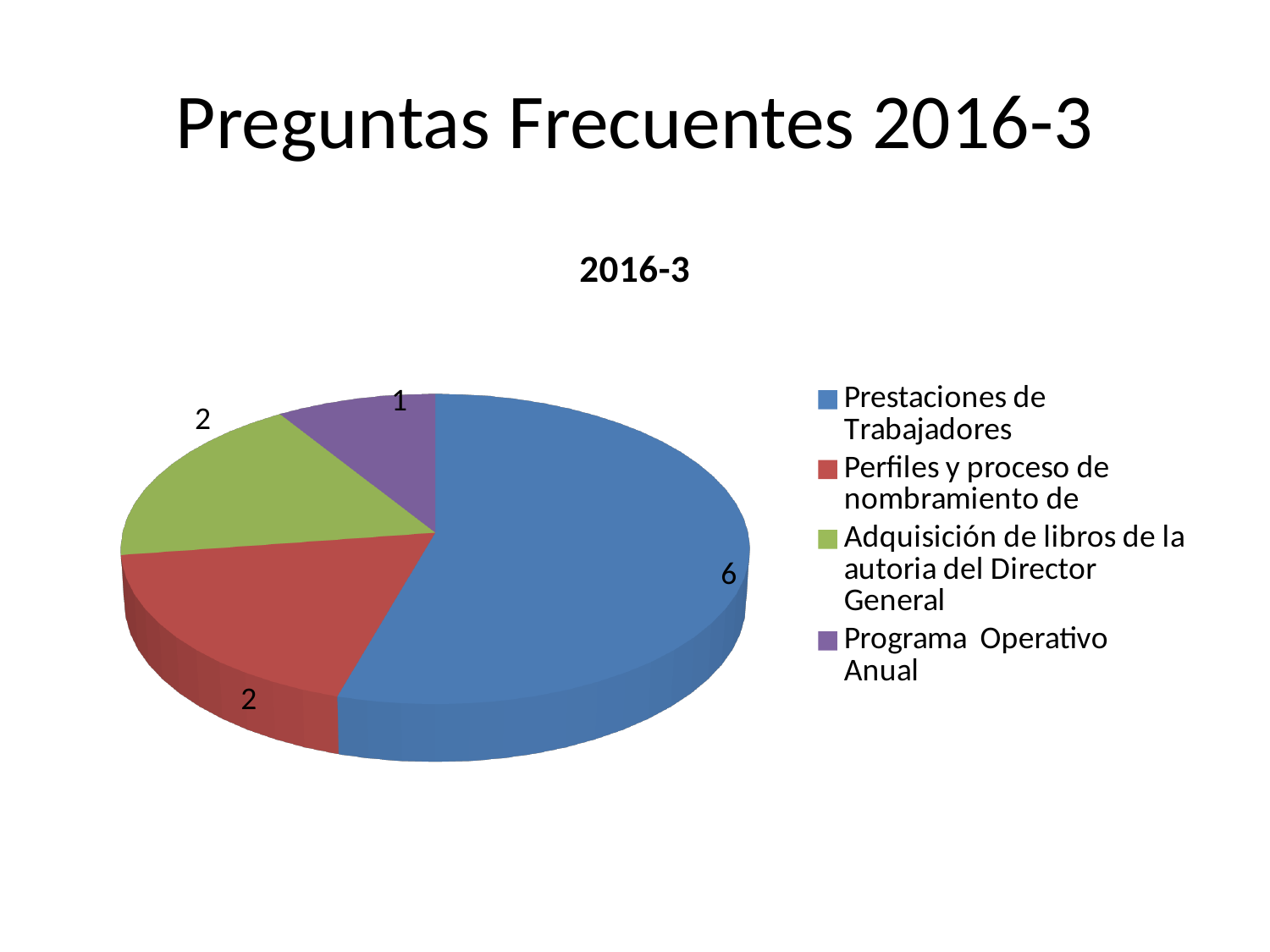
How many categories does the pie chart show? 4 What is the value for Adquisición de libros de la autoria del Director General? 2 What is the title of the chart? 2016-3 What type of chart is shown on the slide? pie chart Which category has the largest slice of the pie? Prestaciones de Trabajadores What is the difference between the values for Prestaciones de Trabajadores and Perfiles y proceso de nombramiento de? 4 What is the value for Programa Operativo Anual? 1 What is the value for Prestaciones de Trabajadores? 6 Which is larger, the value for Prestaciones de Trabajadores or the value for Programa Operativo Anual? Prestaciones de Trabajadores What is the total of all the values shown in the pie chart? 11 Which category has the smallest slice of the pie? Programa Operativo Anual What is the difference between the values for Adquisición de libros de la autoria del Director General and Programa Operativo Anual? 1